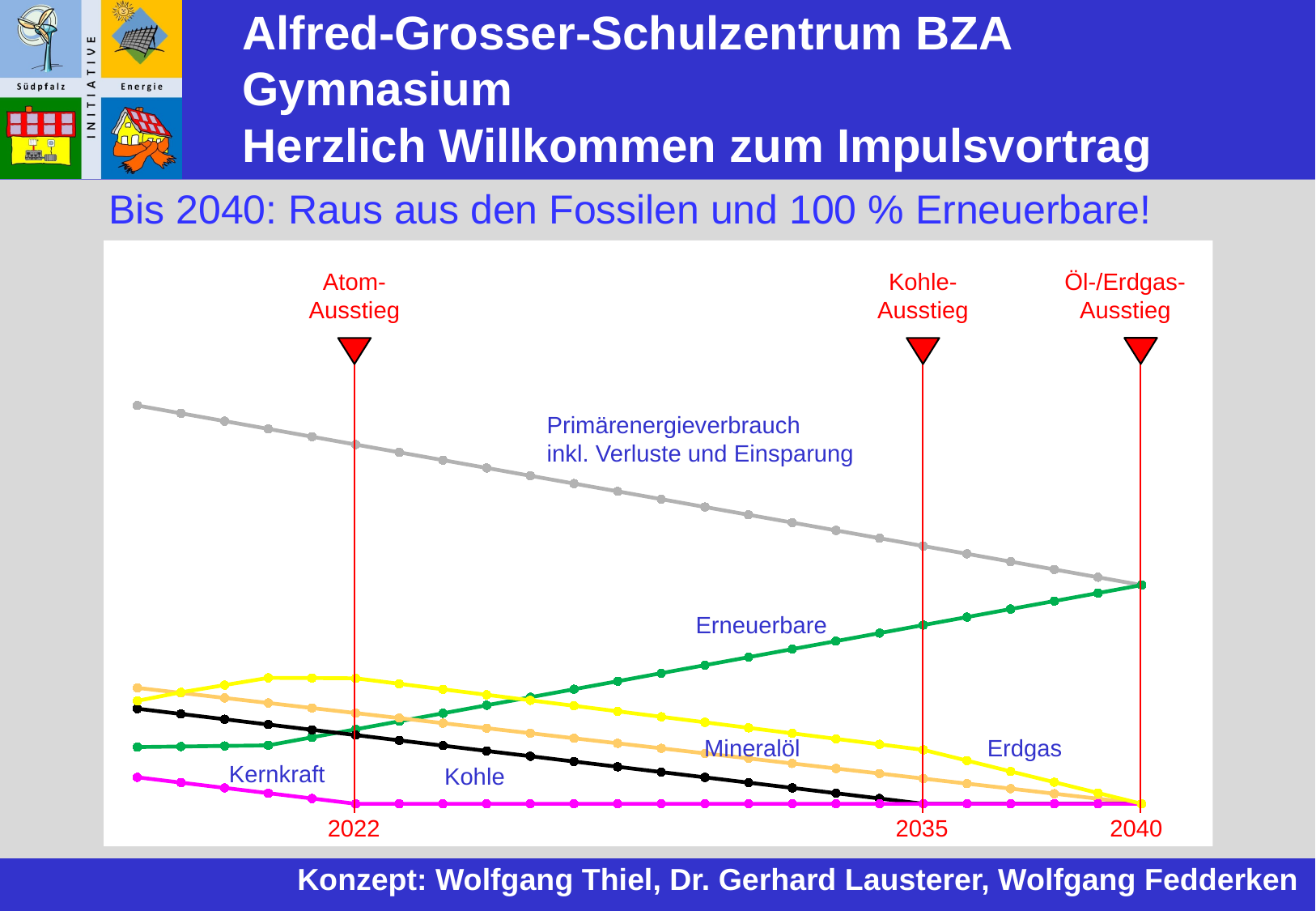
At 2035, which is larger: Erneuerbare or Erdgas? Erneuerbare Does the Erneuerbare line rise or fall from left to right? rise Which series has the highest value at 2040? Primärenergieverbrauch and Erneuerbare (they meet at the same value) In which year does the chart mark the Kohle-Ausstieg? 2035 Which year labels are shown on the x axis? 2022, 2035, 2040 What kind of chart is shown on the slide? line chart Which series has the highest value at the left edge of the chart? Primärenergieverbrauch Does the Primärenergieverbrauch line rise or fall from left to right? fall What is the title above the chart? Bis 2040: Raus aus den Fossilen und 100 % Erneuerbare! How many labelled data series are plotted in the chart? 6 At 2022, which is larger: Erdgas or Kernkraft? Erdgas Does the Kohle line rise or fall from left to right? fall